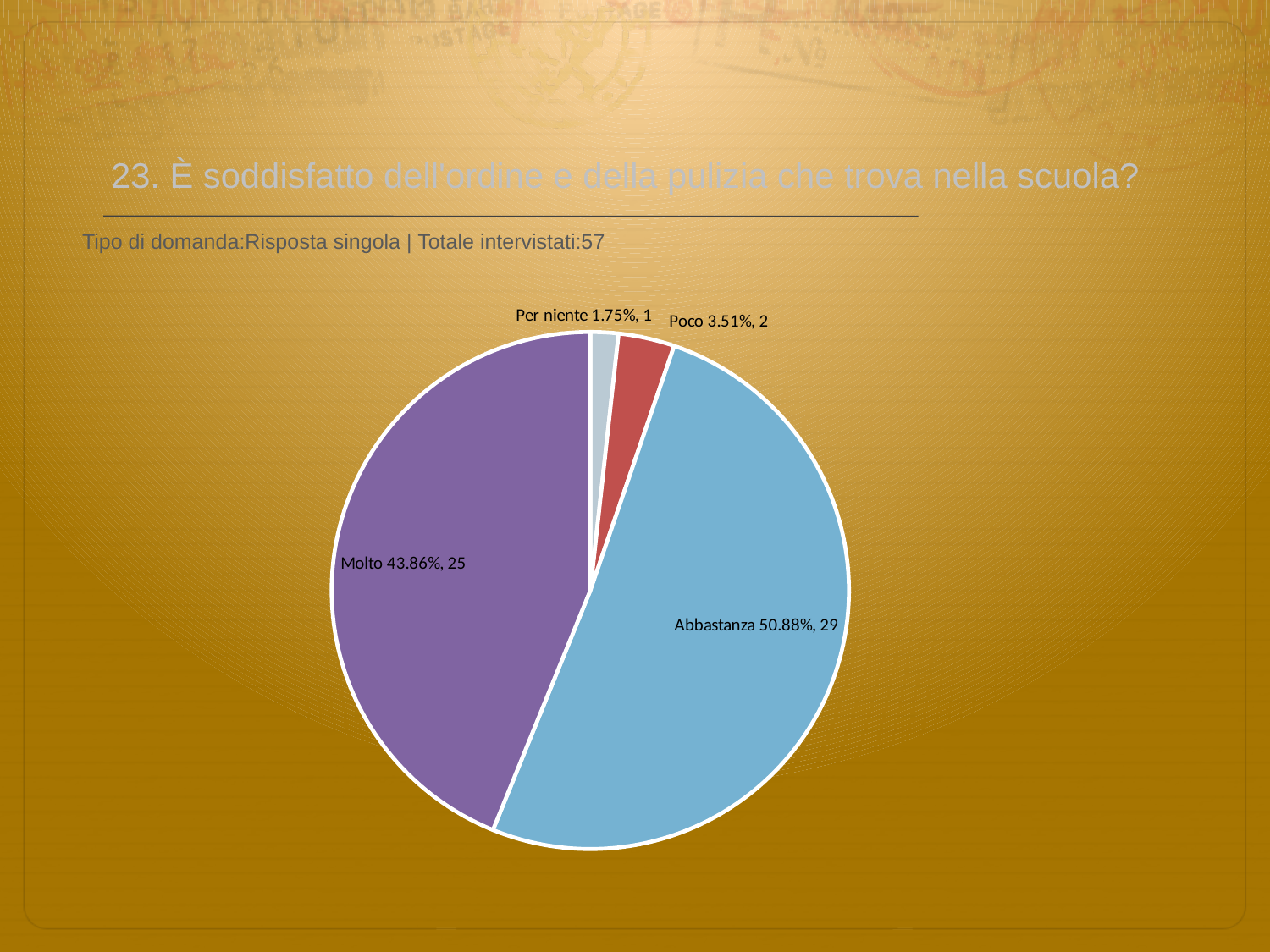
How many respondents answered 'Molto'? 25 What kind of chart is shown on the slide? pie chart Which has more respondents, 'Poco' or 'Per niente'? Poco What colour is the 'Molto' slice? purple What percentage share does the 'Abbastanza' slice represent? 50.88% What is the difference in number of respondents between 'Abbastanza' and 'Molto'? 4 How many slices does the pie chart have? 4 Which category has the smallest slice of the pie? Per niente How many respondents answered 'Poco'? 2 What is the total number of respondents across all slices? 57 What percentage share does the 'Per niente' slice represent? 1.75% Which category has the largest slice of the pie? Abbastanza